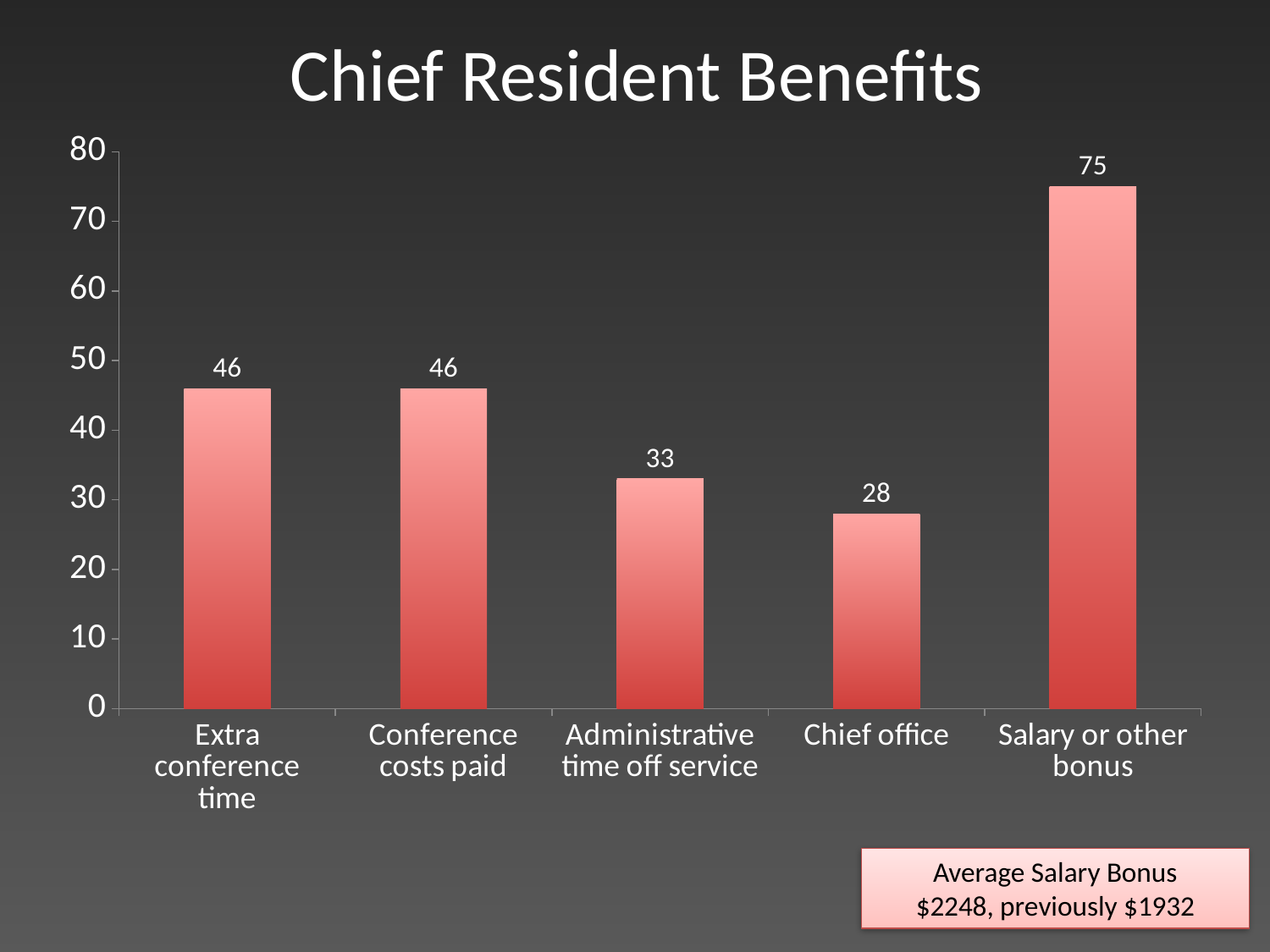
What is the title of the chart? Chief Resident Benefits What is the value for Administrative time off service? 33 Which is larger, the value for Administrative time off service or the value for Chief office? Administrative time off service Which category has the highest value? Salary or other bonus What kind of chart is shown on the slide? Bar chart What is the value for Extra conference time? 46 How many categories are shown on the x axis? 5 Which category has the lowest value? Chief office What is the difference between the values for Conference costs paid and Administrative time off service? 13 What is the value for Salary or other bonus? 75 What is the value for Chief office? 28 What is the difference between the values for Salary or other bonus and Chief office? 47